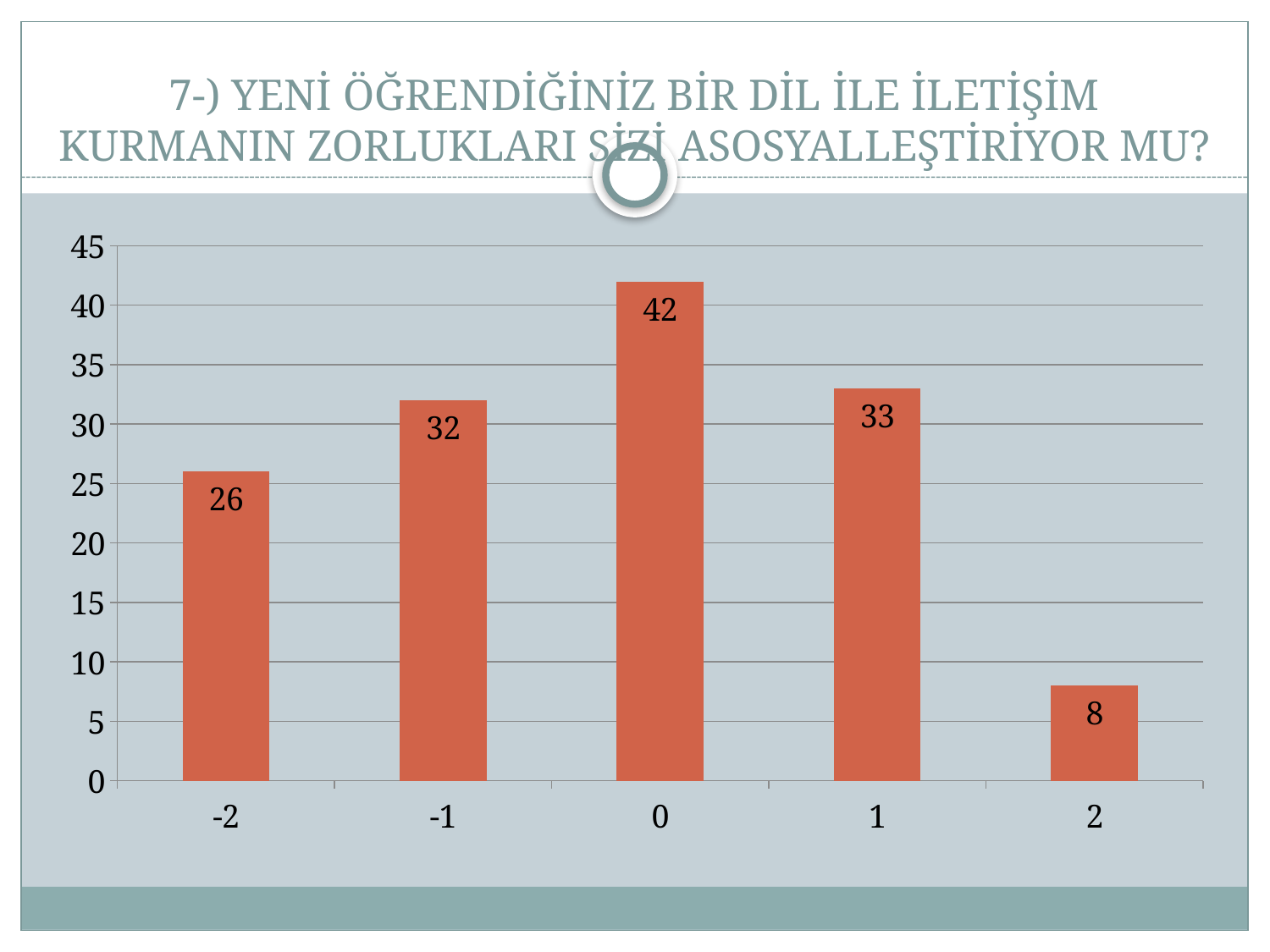
Which category has the highest value? 0 What is the value for category 0? 42 What is the value for category 1? 33 Is the value for category -2 greater or less than 30? less What kind of chart is shown on the slide? bar chart What is the value for category 2? 8 Which is larger, the value for category -1 or the value for category -2? -1 How many categories are shown on the x axis? 5 What is the value for category -2? 26 What is the difference between the values for category 1 and category -1? 1 What is the difference between the values for category 0 and category 2? 34 Which category has the lowest value? 2